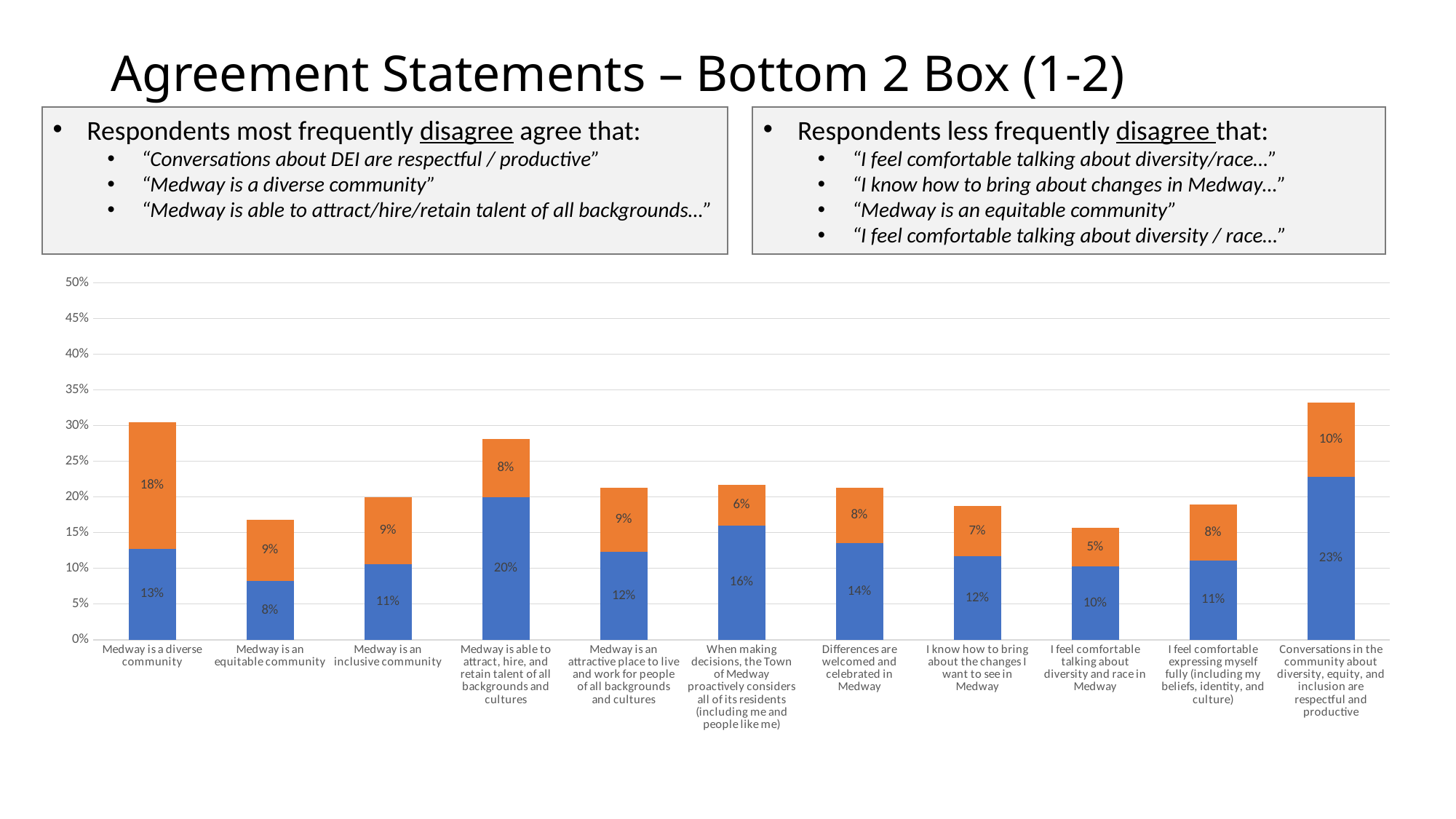
Which statement has the highest orange segment value? Medway is a diverse community What is the value of the blue segment for "Conversations in the community about diversity, equity, and inclusion are respectful and productive"? 23% What is the value of the blue segment for "Medway is a diverse community"? 13% What is the value of the orange segment for "Medway is a diverse community"? 18% What is the difference between the blue segment values for "Medway is able to attract, hire, and retain talent of all backgrounds and cultures" and "Medway is an equitable community"? 12% Which statement has the highest blue segment value? Conversations in the community about diversity, equity, and inclusion are respectful and productive Which statement has the lowest blue segment value? Medway is an equitable community Which is larger: the blue segment for "Differences are welcomed and celebrated in Medway" or the blue segment for "I know how to bring about the changes I want to see in Medway"? Differences are welcomed and celebrated in Medway How many statements (categories) are shown on the x axis of the chart? 11 What kind of chart is shown on the slide? Stacked bar chart What is the value of the orange segment for "I feel comfortable talking about diversity and race in Medway"? 5% Is the total stacked value for "Medway is an equitable community" greater or less than 20%? less